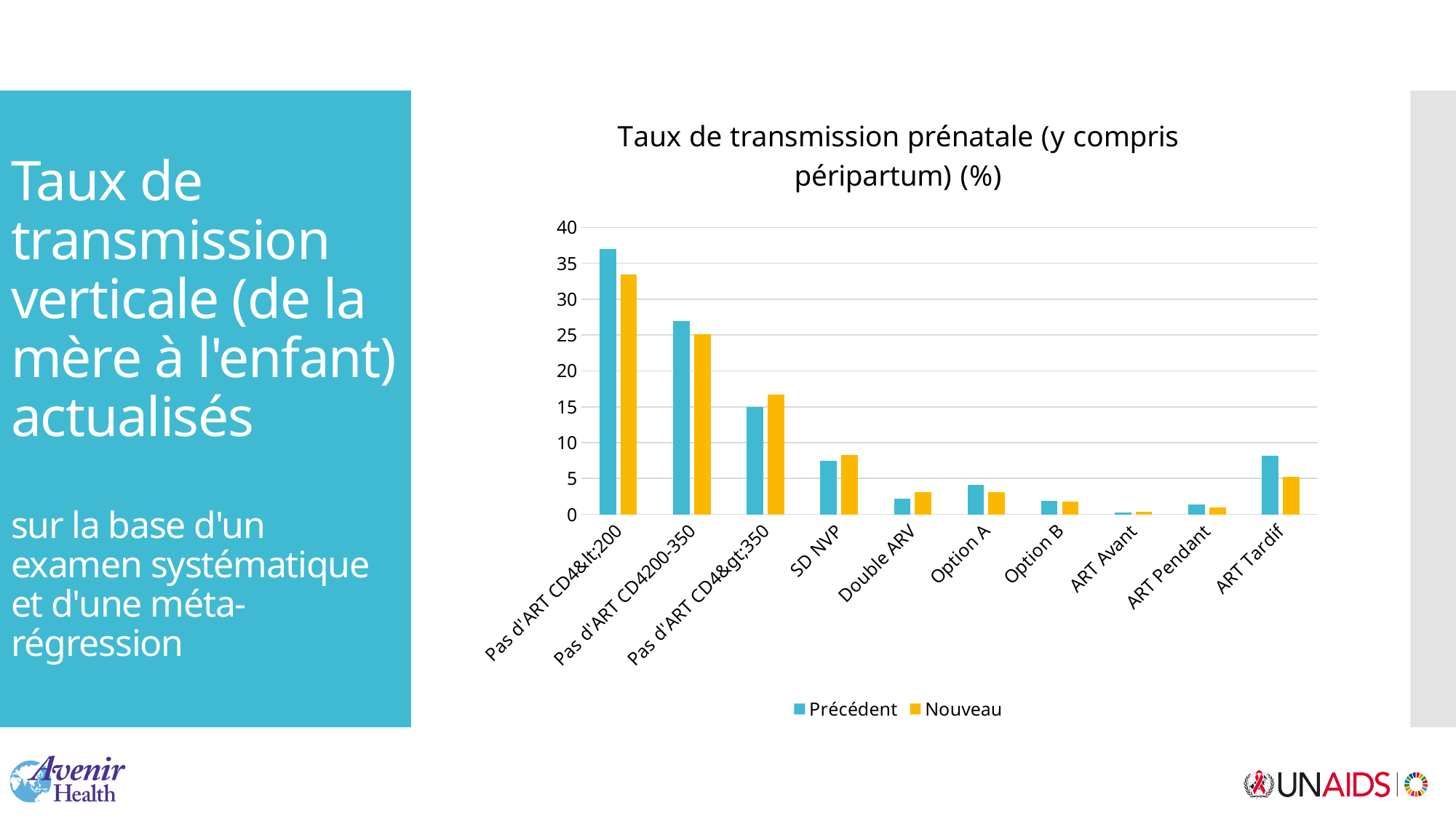
For ART Tardif, which is larger: the Précédent value or the Nouveau value? Précédent What are the two series named in the legend? Précédent and Nouveau For Option A, which is larger: the Précédent value or the Nouveau value? Précédent Is the Précédent value for ART Tardif greater or less than 5? greater Which category has the highest Précédent value? Pas d'ART CD4&lt;200 Which category has the lowest Précédent value? ART Avant How many series does the legend list? 2 How many categories are shown on the x axis? 10 Do the Précédent values rise or fall across the first four categories from left to right? fall What kind of chart is shown on the slide? bar chart Is the Précédent value for Pas d'ART CD4&lt;200 greater or less than 35? greater Is the Nouveau value for Pas d'ART CD4200-350 greater or less than 30? less